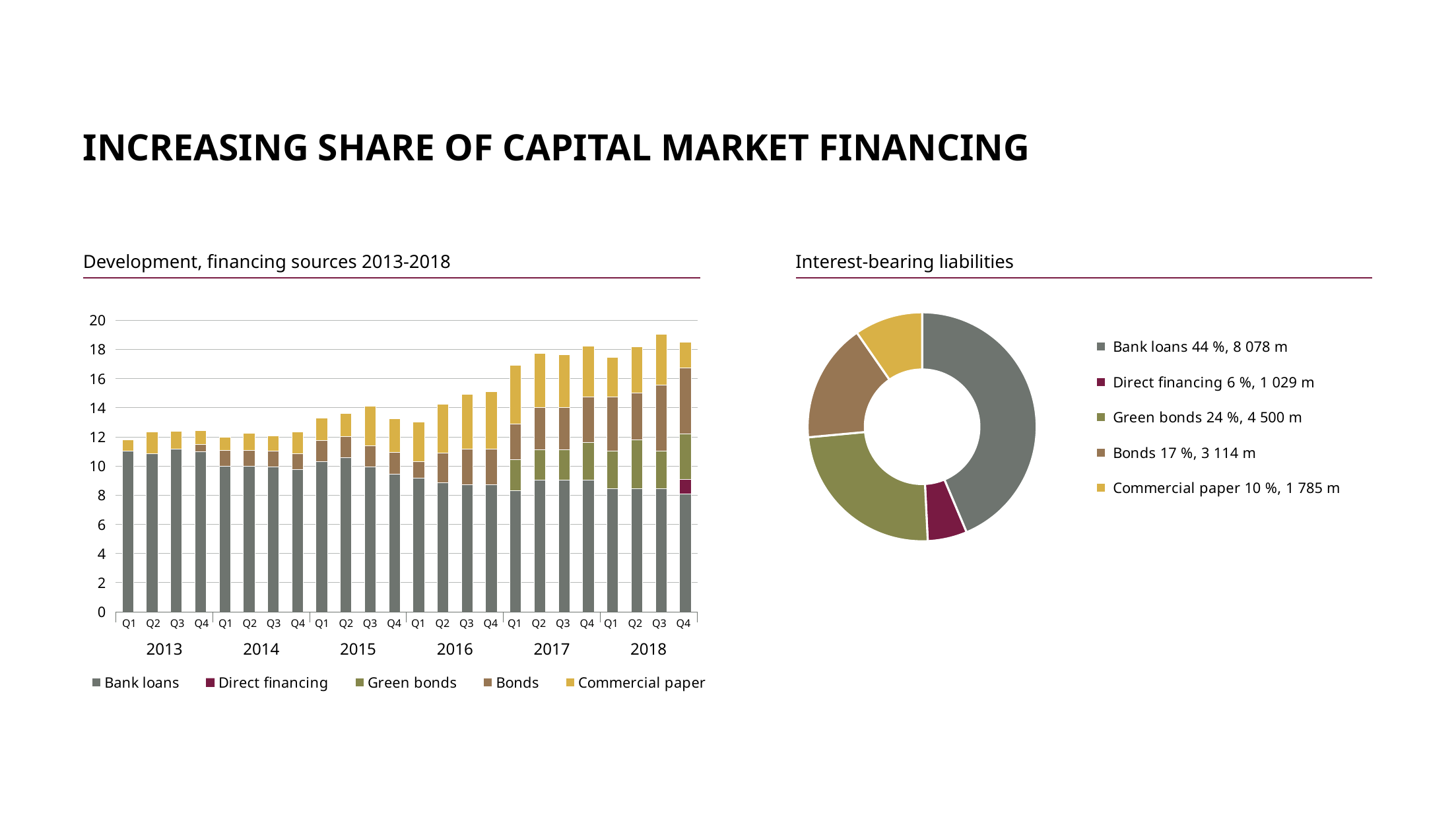
How many categories does the 'Interest-bearing liabilities' chart show? 5 In the 'Interest-bearing liabilities' chart, which is larger: Green bonds or Bonds? Green bonds In the 'Interest-bearing liabilities' chart, what is the value for Bank loans? 8 078 m In the 'Interest-bearing liabilities' chart, which category has the smallest value? Direct financing In the 'Interest-bearing liabilities' chart, which category has the largest value? Bank loans What kind of chart is 'Interest-bearing liabilities'? Donut chart How many series does the legend of the 'Development, financing sources 2013-2018' chart list? 5 In the 'Development, financing sources 2013-2018' chart, do the total bar heights generally rise or fall from 2013 to 2018? Rise What kind of chart is 'Development, financing sources 2013-2018'? Stacked bar chart In the 'Interest-bearing liabilities' chart, what is the difference in percentage points between Bonds and Commercial paper? 7 In the 'Development, financing sources 2013-2018' chart, is the total for Q3 2018 greater or less than 18? greater In the 'Interest-bearing liabilities' chart, what share do Green bonds represent? 24 %